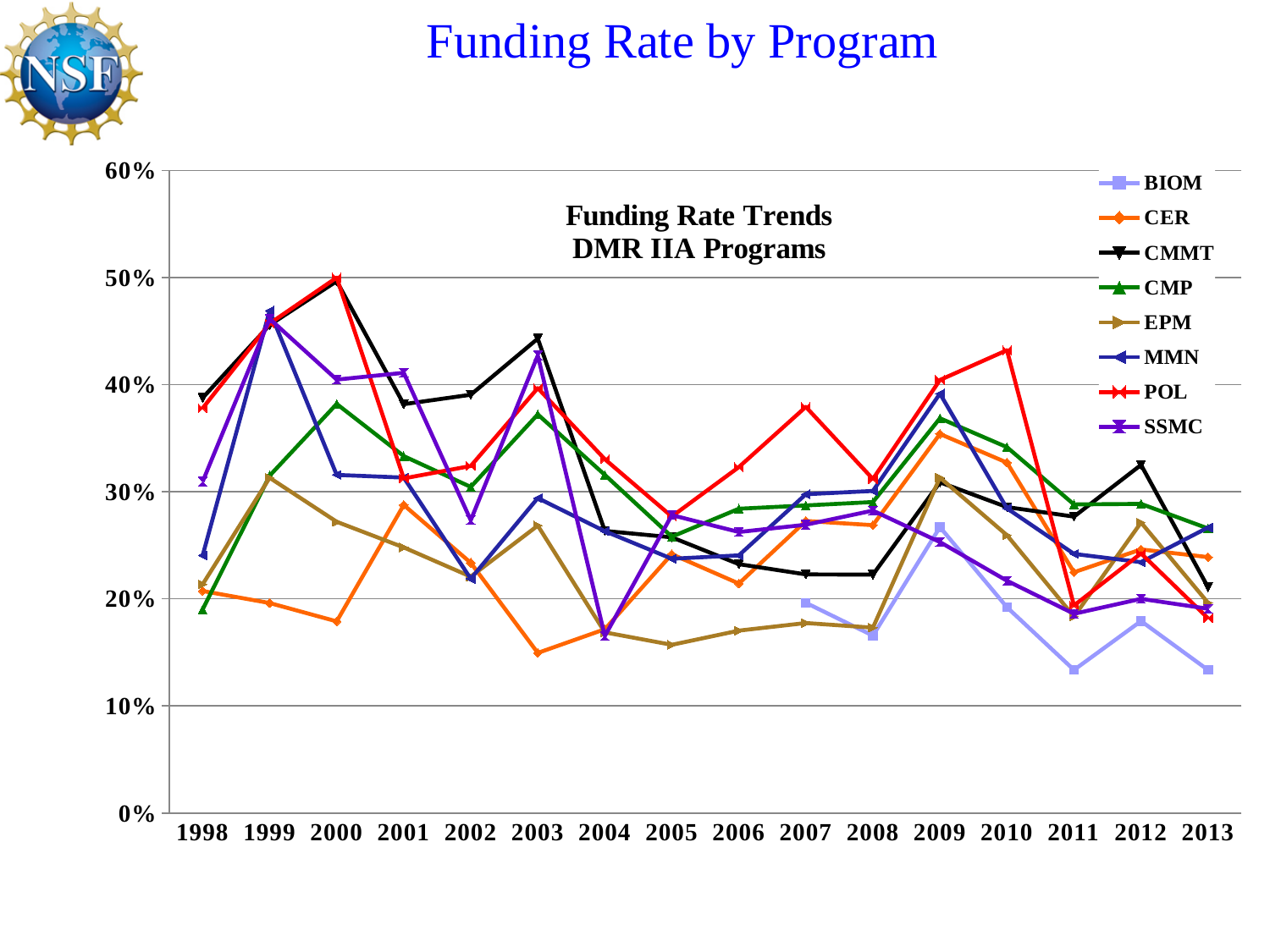
What is the title printed inside the chart area? Funding Rate Trends DMR IIA Programs In 2007, which has the higher funding rate, POL or CER? POL How many series does the legend list? 8 Is the value for BIOM in 2011 greater or less than 20%? less How many years are shown along the x axis? 16 Which program has the highest funding rate in 2010? POL Does the BIOM funding rate rise or fall from 2009 to 2011? fall Is the value for CMMT in 2003 greater or less than 40%? greater Is the value for EPM in 2005 greater or less than 20%? less What kind of chart is shown on the slide? line chart Which program has the lowest funding rate in 2013? BIOM